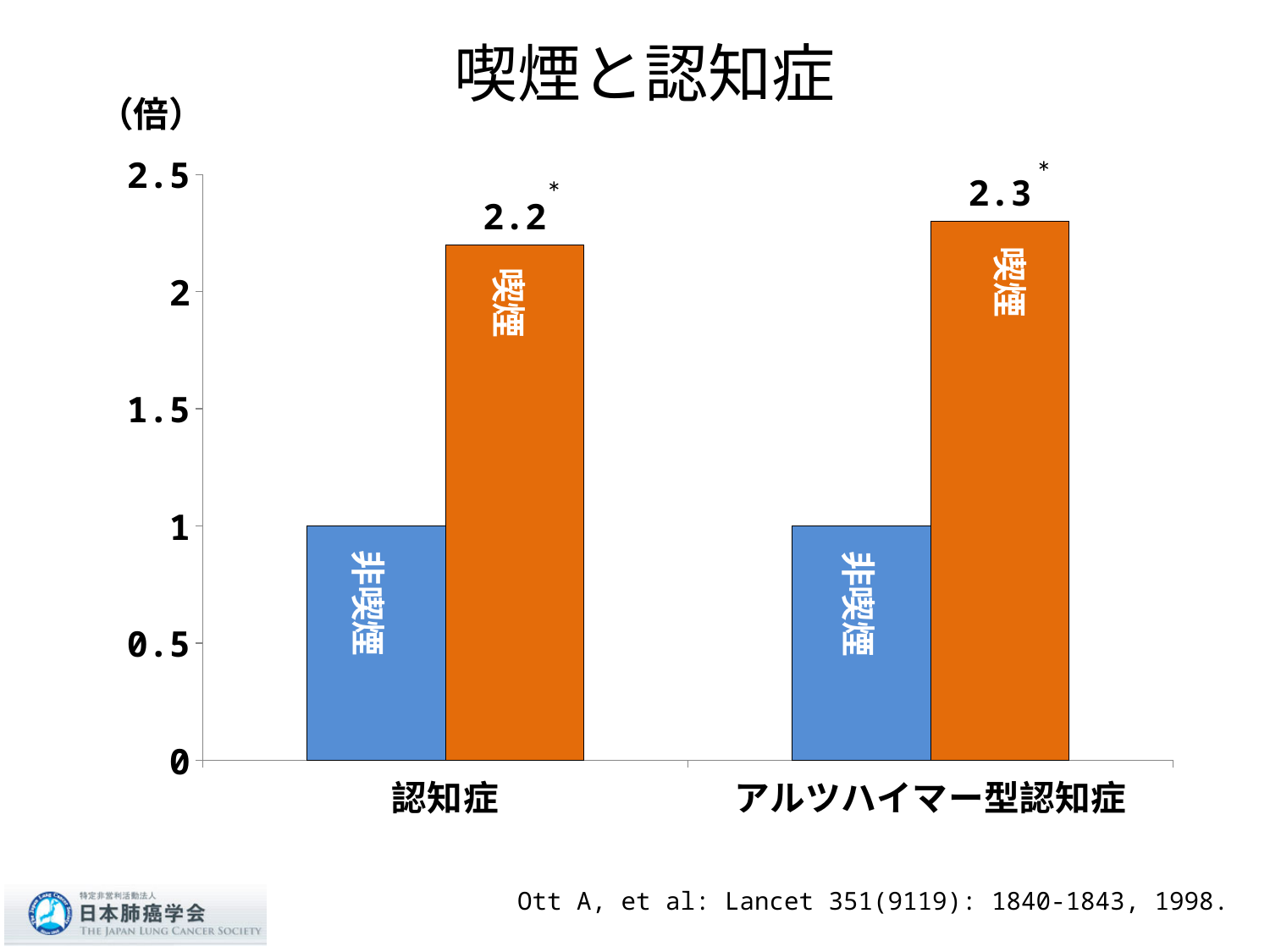
What is the value for 喫煙 in the アルツハイマー型認知症 category? 2.3 What is the value for 非喫煙 in the アルツハイマー型認知症 category? 1 What kind of chart is shown on the slide? Bar chart Which is larger: the 喫煙 value for 認知症 or the 喫煙 value for アルツハイマー型認知症? アルツハイマー型認知症 What is the value for 喫煙 in the 認知症 category? 2.2 What is the title of the chart? 喫煙と認知症 What is the difference between the 喫煙 and 非喫煙 values in the アルツハイマー型認知症 category? 1.3 What is the value for 非喫煙 in the 認知症 category? 1 Is the value for 喫煙 in the 認知症 category greater or less than 2? greater How many categories are shown on the x axis? 2 Which bar has the highest value on the chart? 喫煙 in アルツハイマー型認知症 (2.3) What is the difference between the 喫煙 and 非喫煙 values in the 認知症 category? 1.2